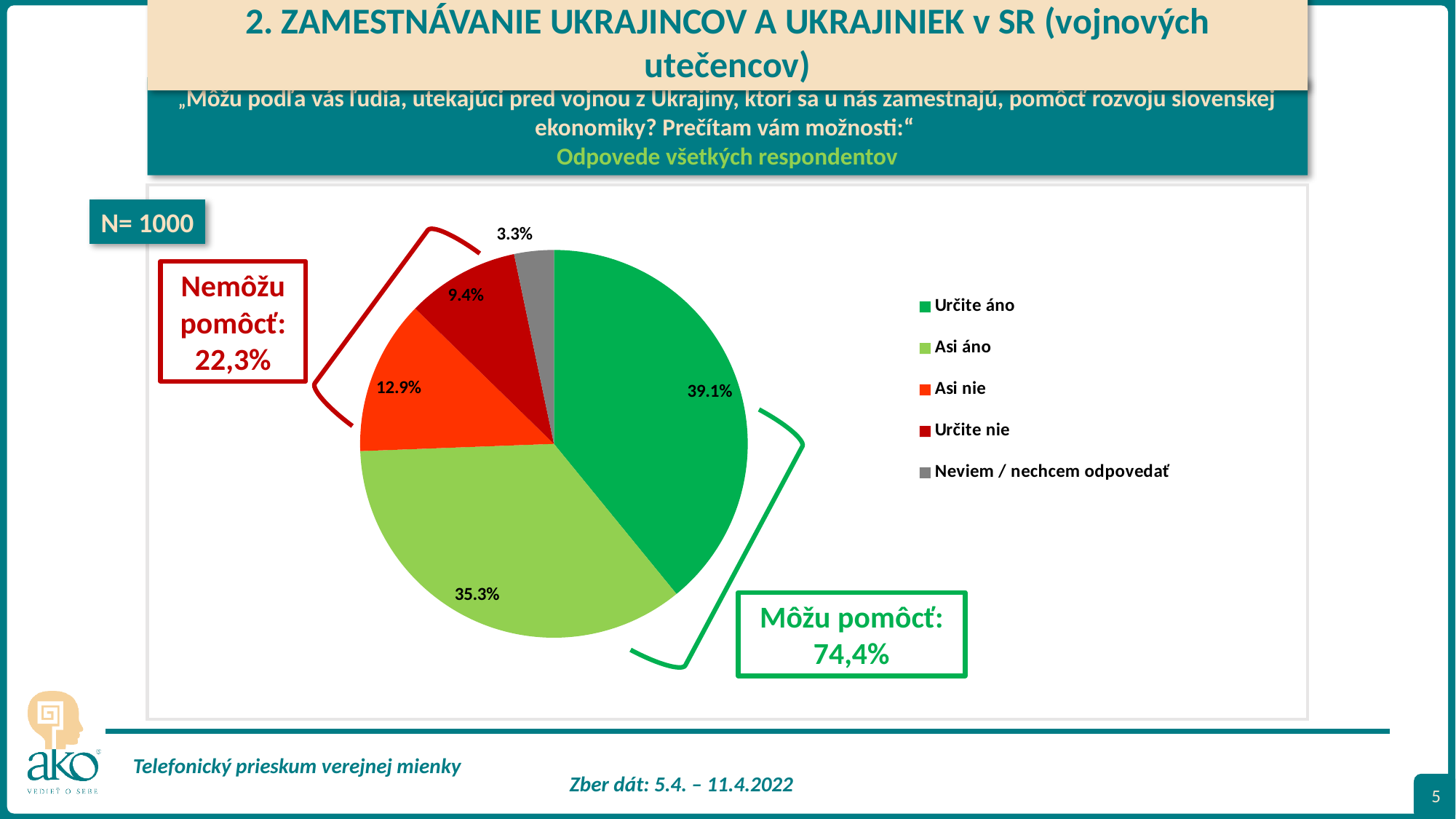
How many slices does the pie chart have? 5 What is the value for "Asi áno"? 35.3% What colour is the slice for "Určite nie"? dark red What is the value for "Určite nie"? 9.4% What is the value for "Určite áno"? 39.1% Which category has the largest share of the pie? Určite áno Which category has the smallest share of the pie? Neviem / nechcem odpovedať What is the value for "Neviem / nechcem odpovedať"? 3.3% What is the value for "Asi nie"? 12.9% What is the difference between the values for "Určite áno" and "Asi áno"? 3.8% Which is larger, the value for "Asi nie" or the value for "Určite nie"? Asi nie What kind of chart is shown on the slide? pie chart